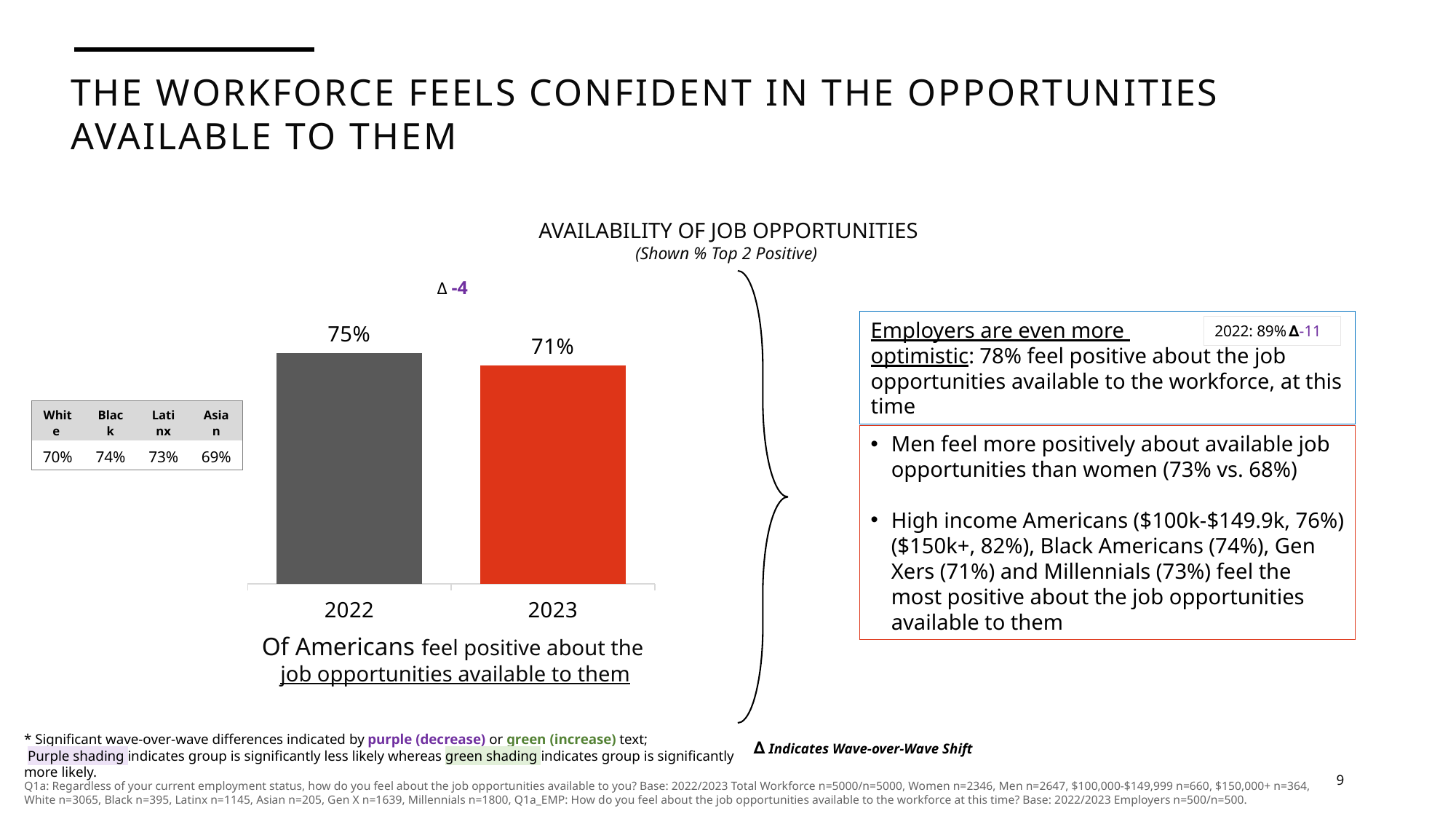
Do the values rise or fall from 2022 to 2023 in the Availability of Job Opportunities chart? fall What is the value for 2023 in the Availability of Job Opportunities chart? 71% What is the subtitle shown under the chart title Availability of Job Opportunities? (Shown % Top 2 Positive) Which year has the higher value in the Availability of Job Opportunities chart? 2022 How many bars are plotted in the Availability of Job Opportunities chart? 2 Is the 2023 value larger or smaller than the 2022 value in the Availability of Job Opportunities chart? smaller Which year has the lower value in the Availability of Job Opportunities chart? 2023 In the small table next to the chart, what is the value for Black? 74% What wave-over-wave shift (Δ) is shown above the bars in the Availability of Job Opportunities chart? -4 What is the difference between the 2022 and 2023 values in the Availability of Job Opportunities chart? 4 percentage points What is the value for 2022 in the Availability of Job Opportunities chart? 75% What kind of chart is used to show Availability of Job Opportunities? bar chart